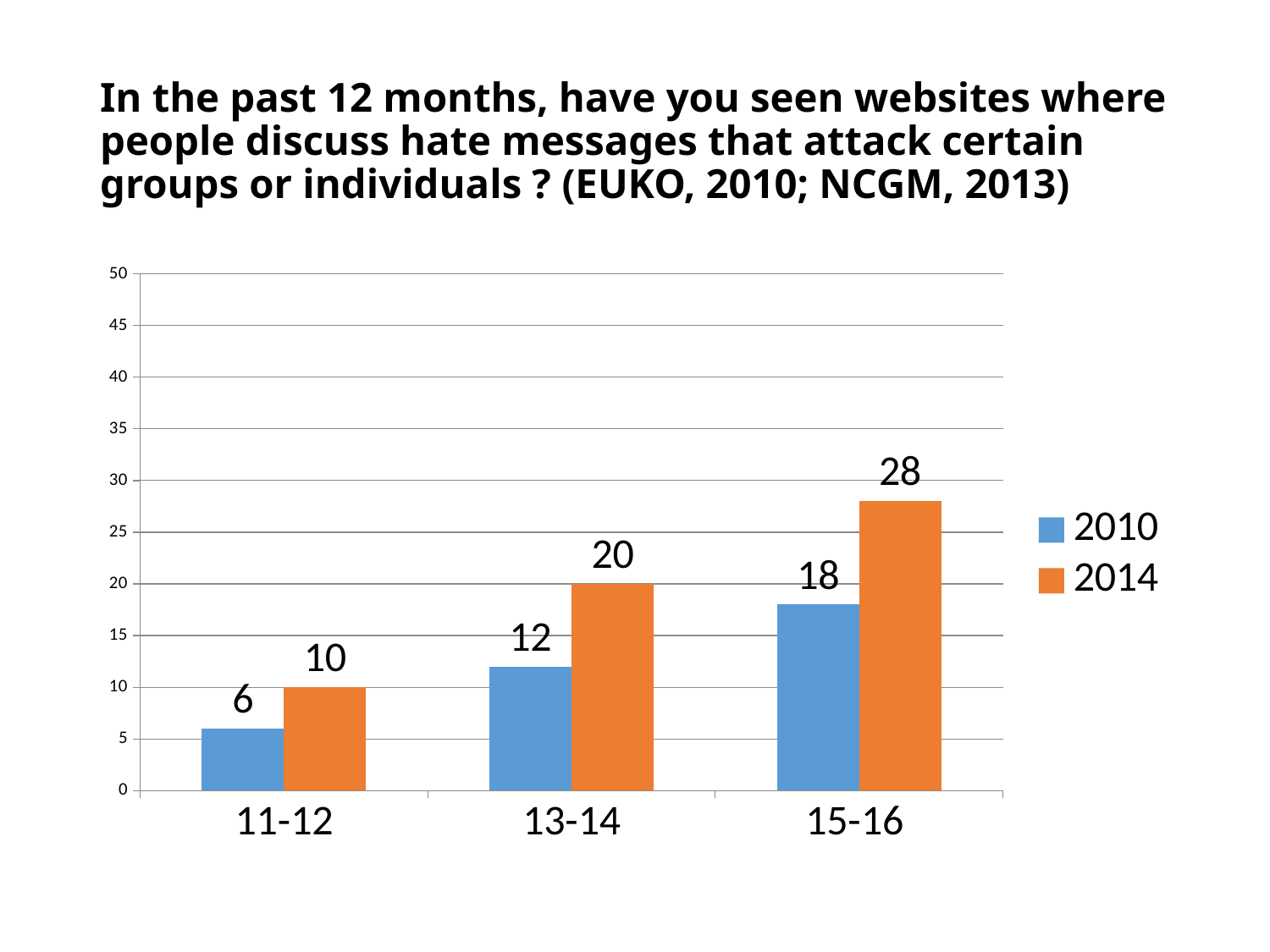
Which age group has the lowest value in the 2010 series? 11-12 What is the value for the 15-16 age group in 2014? 28 How many series does the legend list? 2 What is the difference between the 2014 and 2010 values for the 13-14 age group? 8 How many age groups are shown on the x axis? 3 What is the value for the 11-12 age group in 2010? 6 Which age group has the highest value in the 2014 series? 15-16 Do the 2010 values rise or fall as the age group increases along the x axis? Rise Which is larger for the 11-12 age group: the 2010 value or the 2014 value? 2014 What kind of chart is shown on the slide? Bar chart What is the difference between the 2014 and 2010 values for the 15-16 age group? 10 What is the value for the 13-14 age group in 2014? 20